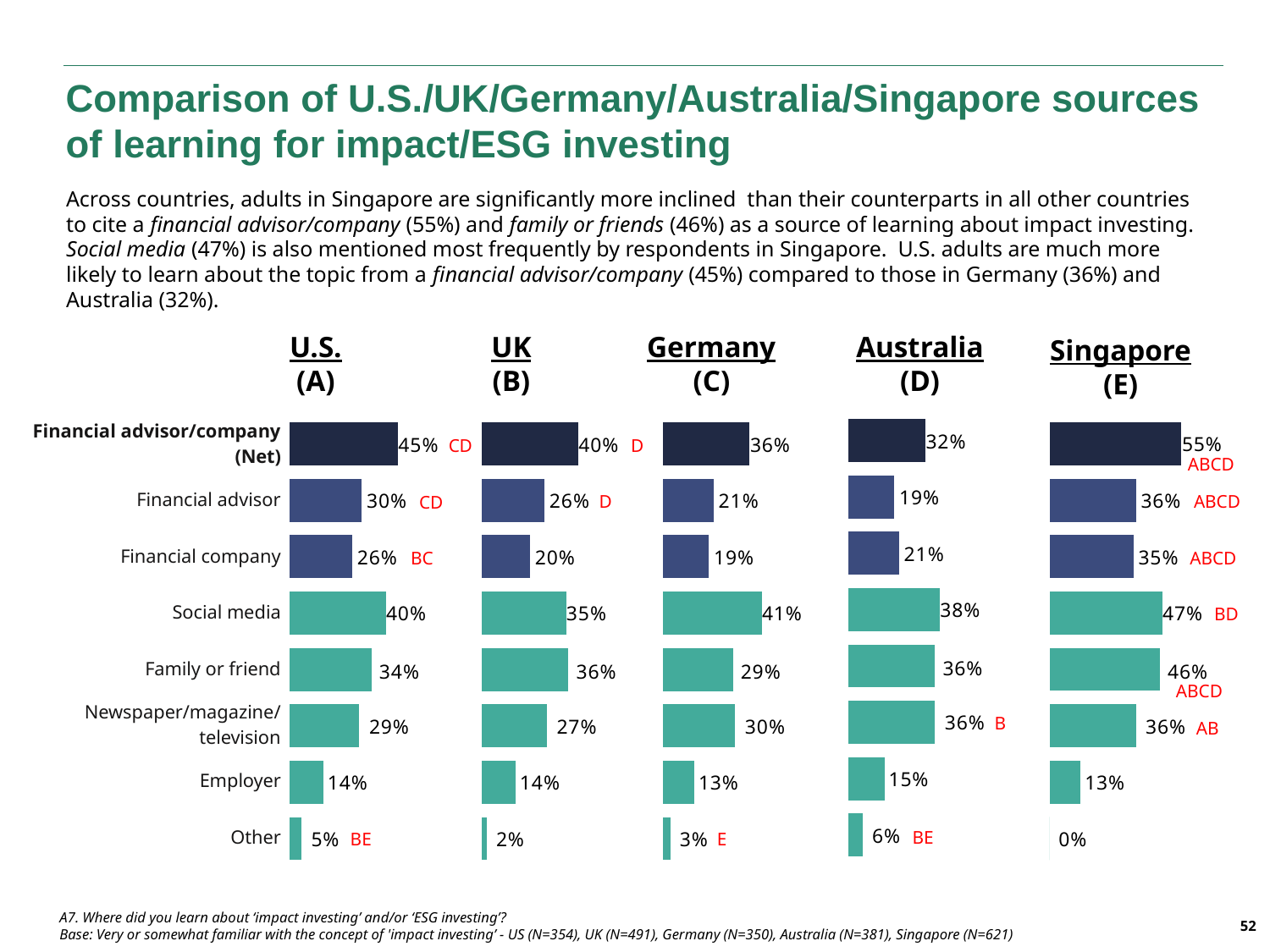
In the Australia chart, which category has the lowest value? Other In the Australia chart, which is larger, Social media or Family or friend? Social media What type of chart is used for each country? Bar chart How many categories are shown in each country's chart? 8 In the Germany chart, which category has the highest value? Social media In the U.S. chart, what is the difference between Financial advisor and Financial company? 4% In the Singapore chart, what is the value for Other? 0% In the UK chart, what is the difference between Financial advisor/company (Net) and Financial advisor? 14% In the U.S. chart, what is the value for Social media? 40% In the Singapore chart, what is the value for Financial advisor/company (Net)? 55% In the Germany chart, what is the value for Employer? 13% How many country charts are shown on the slide? 5